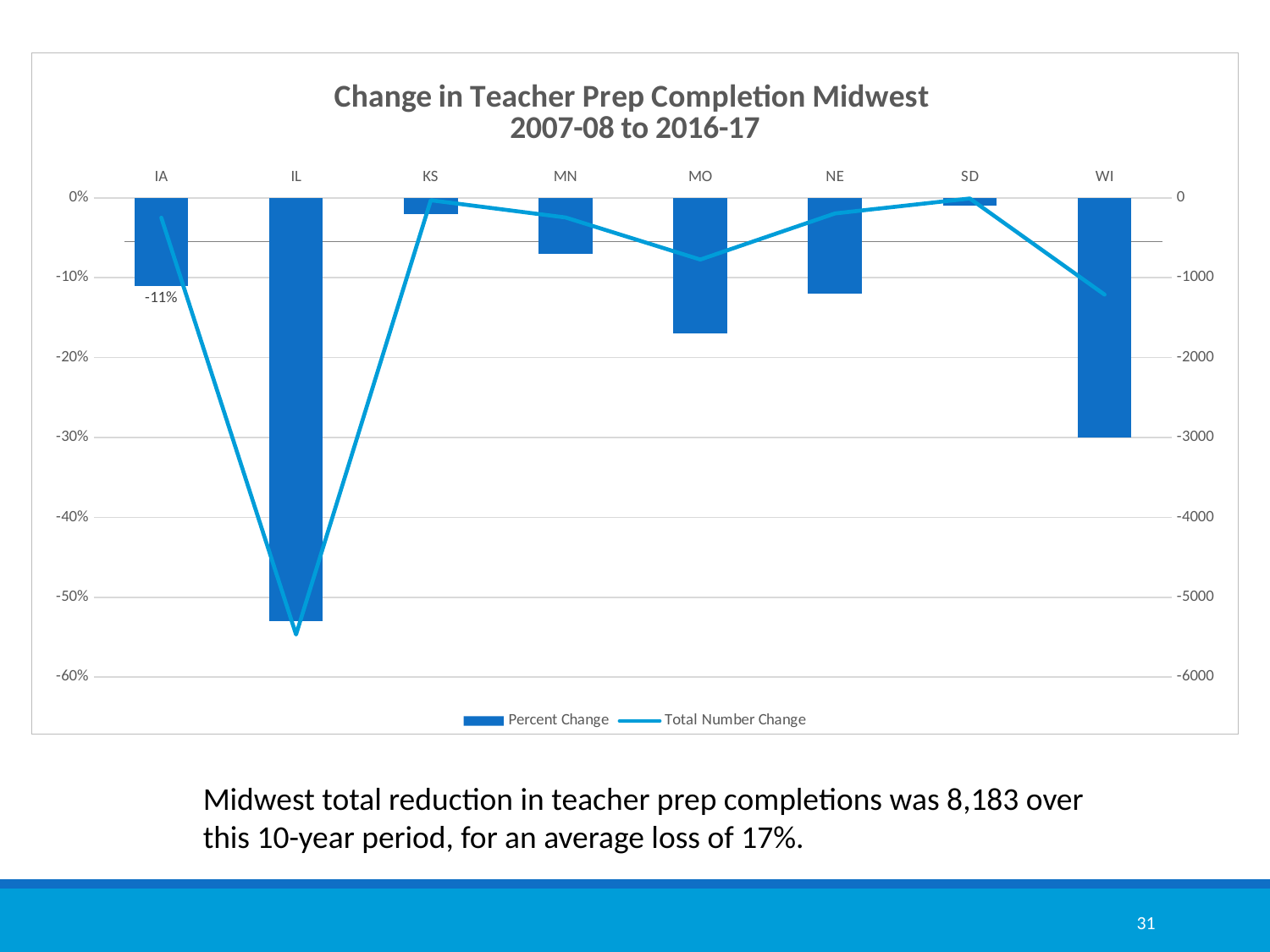
Which state has the largest percentage decrease (lowest Percent Change bar)? IL Is the Total Number Change for IL greater or less than -5000? less Is the Percent Change for WI greater or less than -20%? less Which state has the larger percentage decrease, MO or NE? MO What are the two series named in the legend? Percent Change and Total Number Change Is the Percent Change for KS greater or less than -10%? greater What is the Percent Change for IA? -11% Which state has the largest decrease in Total Number Change? IL How many series does the legend list? 2 What kind of chart is this? Bar chart combined with a line chart How many states are shown on the x axis? 8